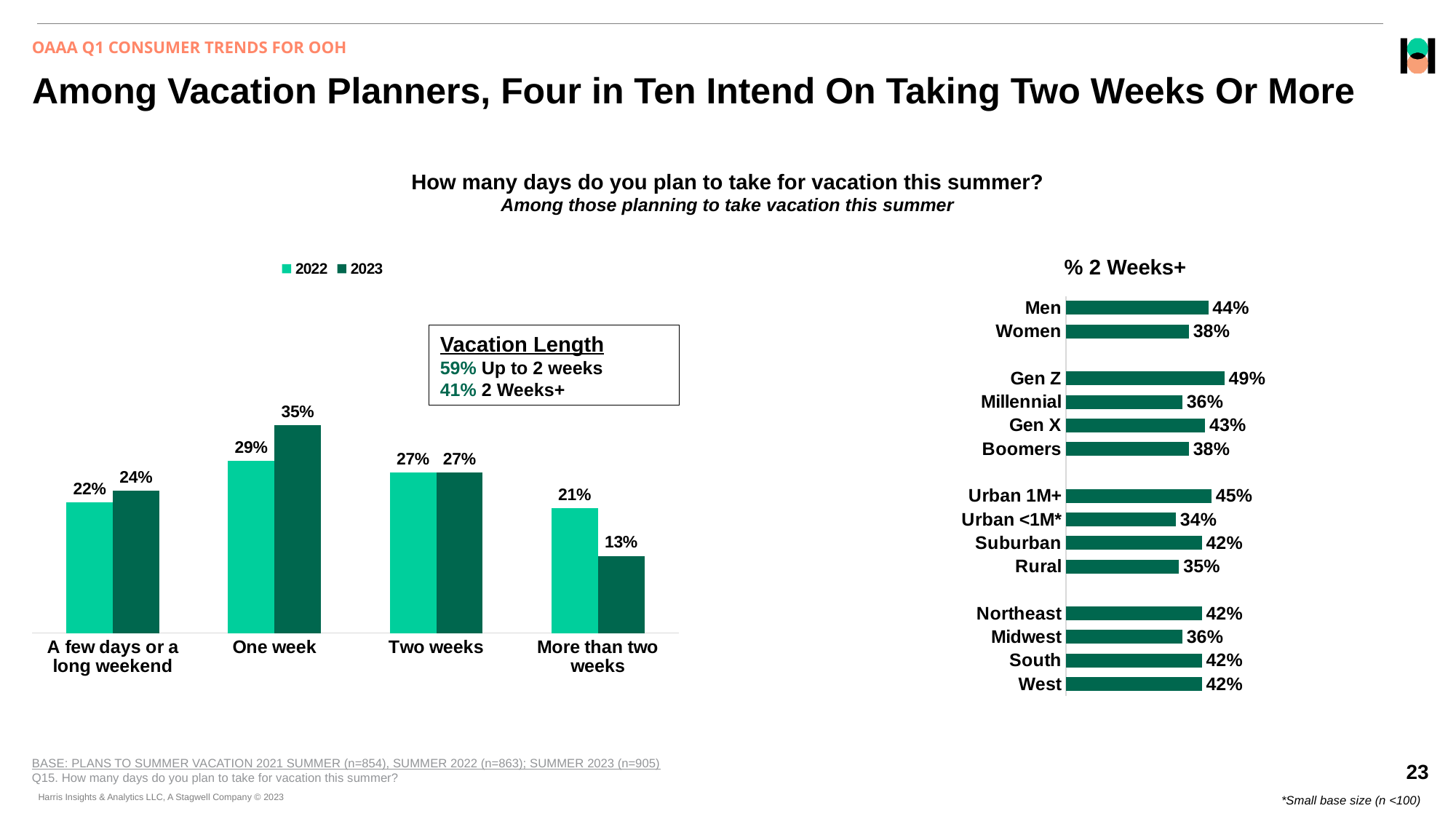
In the left chart (How many days do you plan to take for vacation this summer?), what is the difference between the 2022 and 2023 values for More than two weeks? 8% In the left chart (How many days do you plan to take for vacation this summer?), what is the 2022 value for More than two weeks? 21% In the left chart (How many days do you plan to take for vacation this summer?), which category has the highest 2023 value? One week In the left chart (How many days do you plan to take for vacation this summer?), which category has the lowest 2023 value? More than two weeks In the left chart (How many days do you plan to take for vacation this summer?), how many series does the legend list? 2 In the right chart (% 2 Weeks+), which is larger, the value for Men or the value for Women? Men In the right chart (% 2 Weeks+), what is the difference between Urban 1M+ and Rural? 10% In the right chart (% 2 Weeks+), what is the value for Gen Z? 49% In the left chart (How many days do you plan to take for vacation this summer?), how many categories are shown on the x axis? 4 In the left chart (How many days do you plan to take for vacation this summer?), what is the 2023 value for One week? 35% What kind of chart is the right chart (% 2 Weeks+)? Bar chart In the right chart (% 2 Weeks+), which group has the lowest value? Urban <1M*